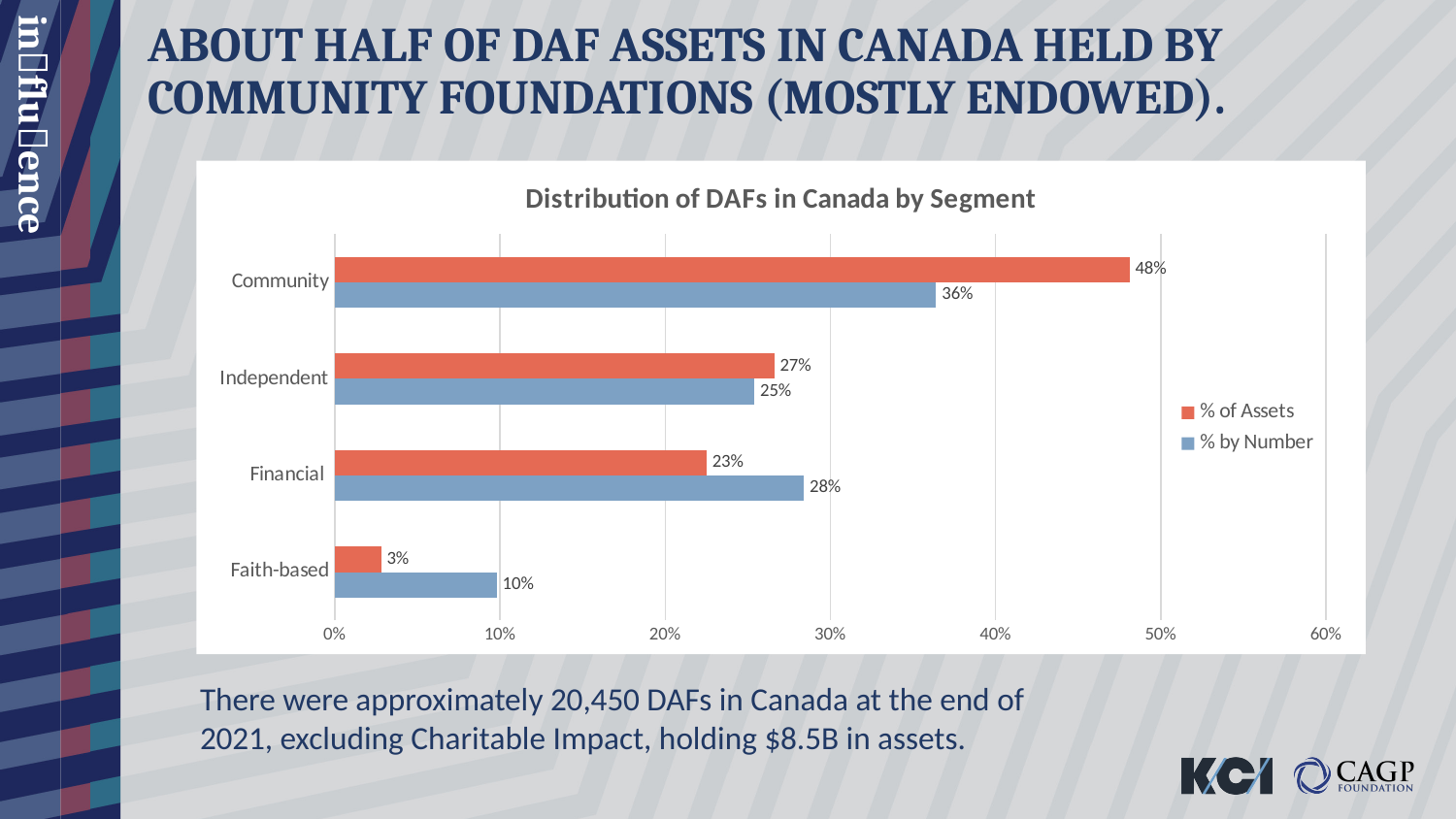
What is the title of the chart? Distribution of DAFs in Canada by Segment What is the % of Assets value for Faith-based? 3% What kind of chart is shown? Bar chart How many segments are shown on the chart? 4 What is the difference between the % of Assets and % by Number values for Community? 12% For Financial, which is larger: % of Assets or % by Number? % by Number What is the % of Assets value for Community? 48% How many series does the legend list? 2 Which segment has the highest % of Assets? Community Which segment has the lowest % by Number? Faith-based What is the % by Number value for Financial? 28% Is the % by Number value for Independent greater or less than 20%? greater